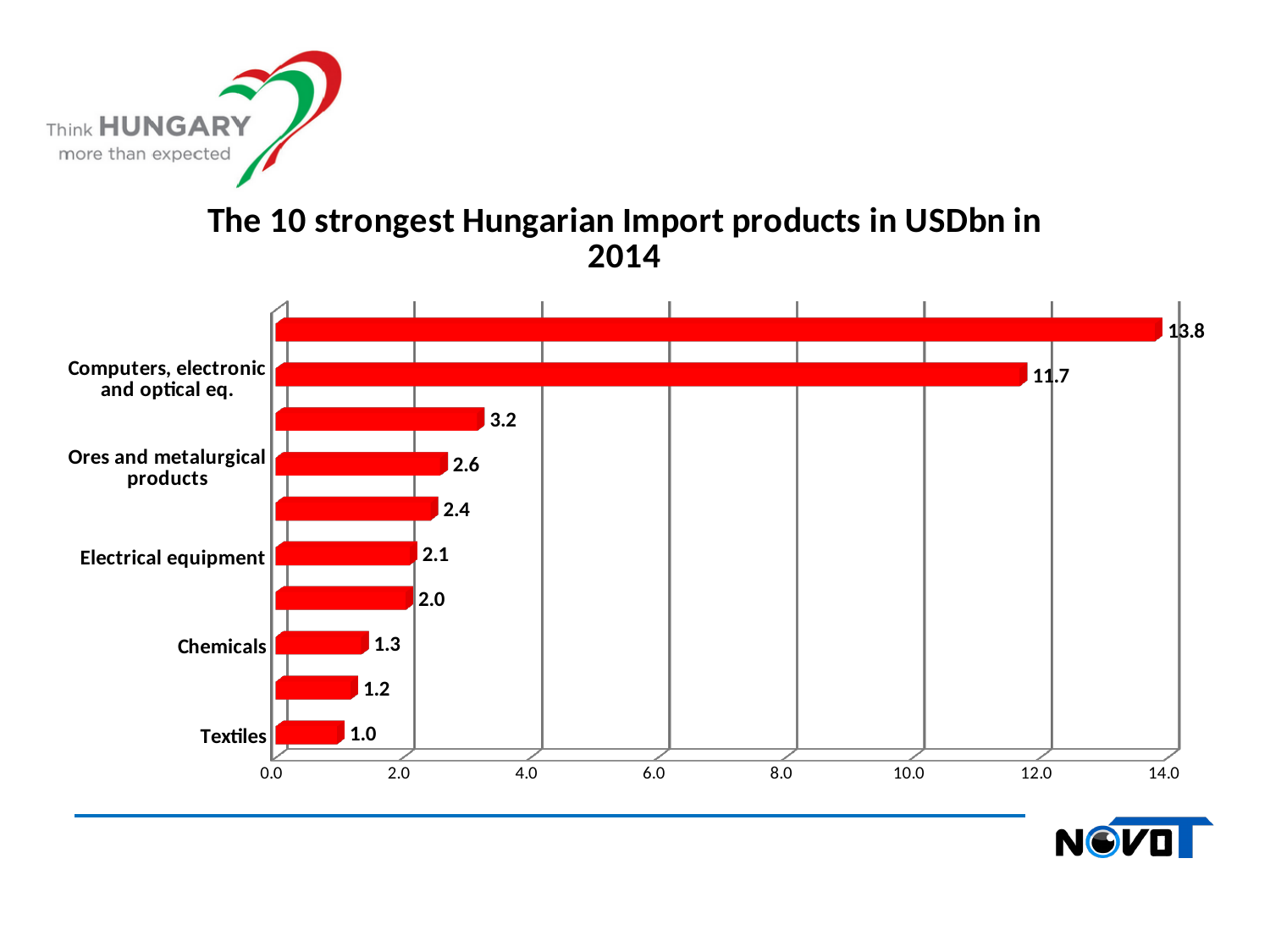
How many bars are plotted on the chart? 10 Which category has the lowest value on the chart? Textiles What kind of chart is shown on the slide? bar chart What is the value for Chemicals? 1.3 What is the value for Ores and metalurgical products? 2.6 What is the largest value shown on the chart? 13.8 What is the value for Electrical equipment? 2.1 Which is larger, the value for Ores and metalurgical products or the value for Electrical equipment? Ores and metalurgical products What is the value for Textiles? 1.0 What is the difference between the values for Computers, electronic and optical eq. and Ores and metalurgical products? 9.1 What is the value for Computers, electronic and optical eq.? 11.7 Is the value for Computers, electronic and optical eq. greater or less than 10.0? greater